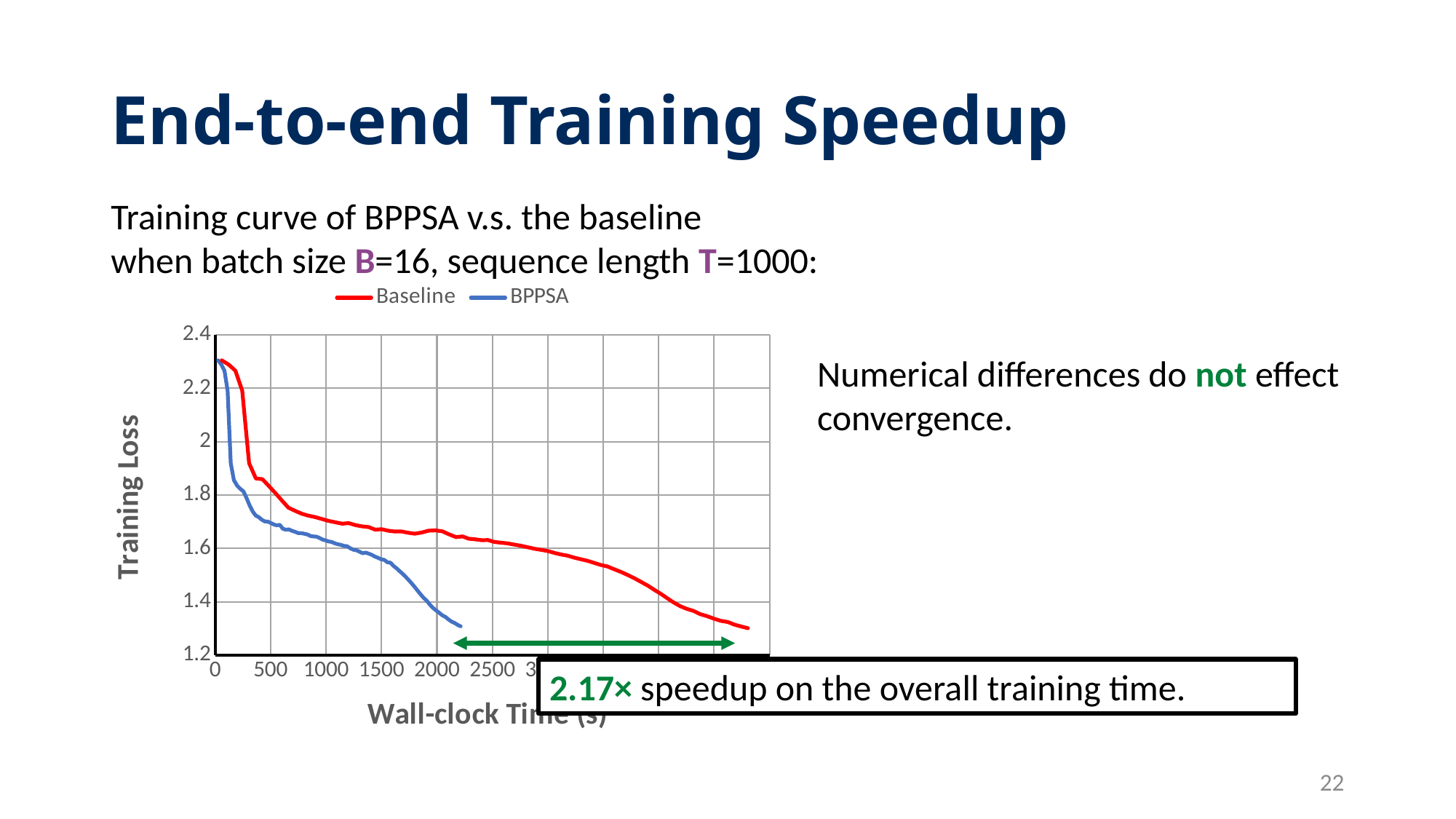
What is the label of the chart's y axis? Training Loss Does the training loss for the Baseline series rise or fall as wall-clock time increases? fall Is the starting training loss of the BPPSA series greater or less than 2.2? greater What are the two series named in the chart's legend? Baseline and BPPSA Is the final training loss reached by the Baseline series greater or less than 1.4? less At 1500 seconds of wall-clock time, which series has the lower training loss, Baseline or BPPSA? BPPSA How many series does the chart's legend list? 2 Does the training loss for the BPPSA series rise or fall as wall-clock time increases? fall Which series is drawn in blue in the chart? BPPSA Is the training loss of the Baseline series at 2000 seconds greater or less than 1.6? greater What kind of chart is shown on the slide? line chart